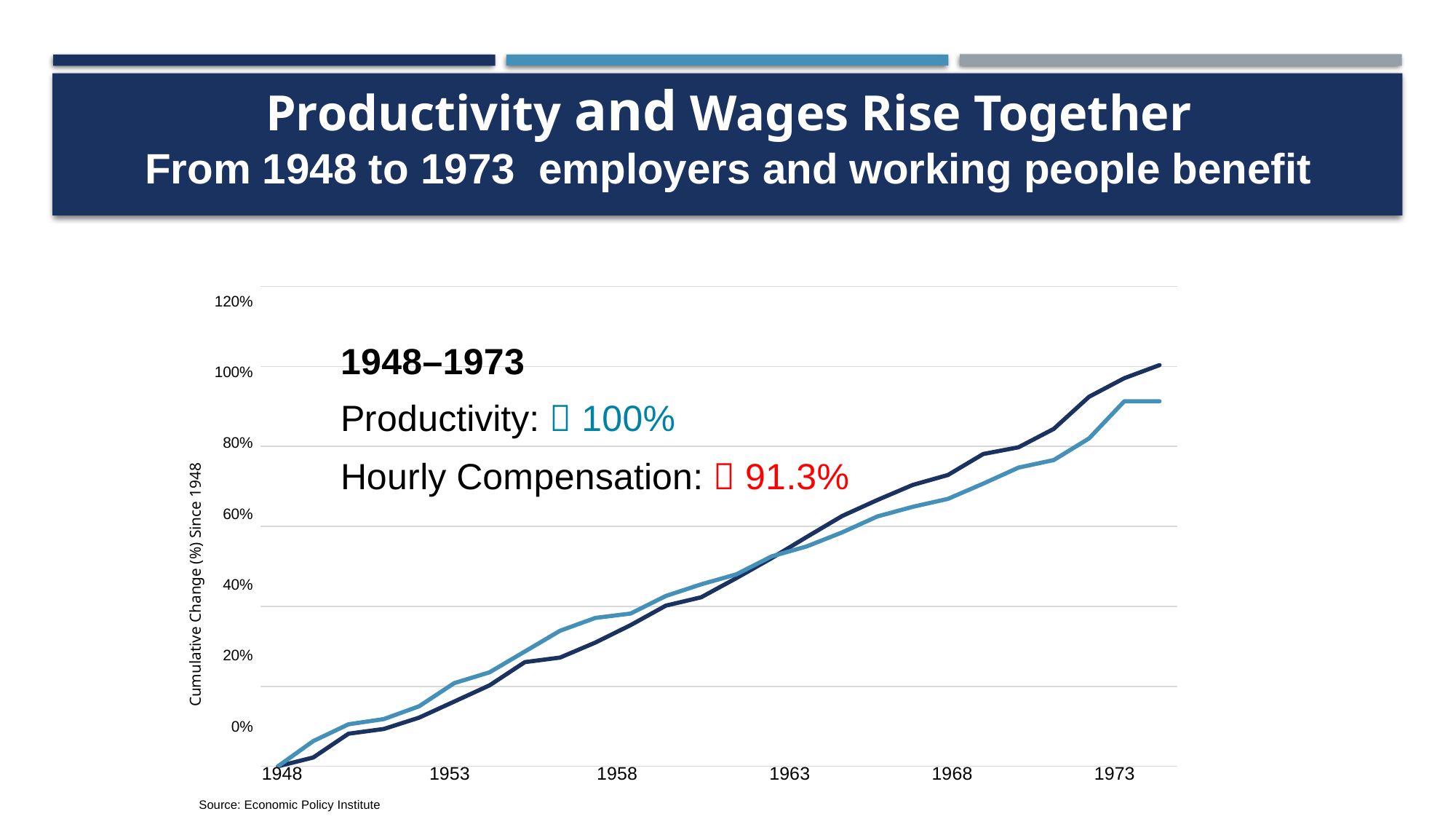
According to the annotation on the chart, by how much did productivity rise from 1948 to 1973? 100% What kind of chart is shown on the slide? line chart Is the value of the dark navy line at 1968 greater or less than 60%? greater What is the difference between the annotated productivity increase and the annotated hourly compensation increase? 8.7 percentage points According to the annotation on the chart, by how much did hourly compensation rise from 1948 to 1973? 91.3% How many year labels are shown on the x axis? 6 Do the plotted lines generally rise or fall from 1948 to 1973? rise How many lines are plotted on the chart? 2 Which rose more from 1948 to 1973, productivity or hourly compensation? Productivity What is the label on the y axis of the chart? Cumulative Change (%) Since 1948 What source is cited below the chart? Economic Policy Institute Is the value of the light blue line at 1958 greater or less than 40%? less